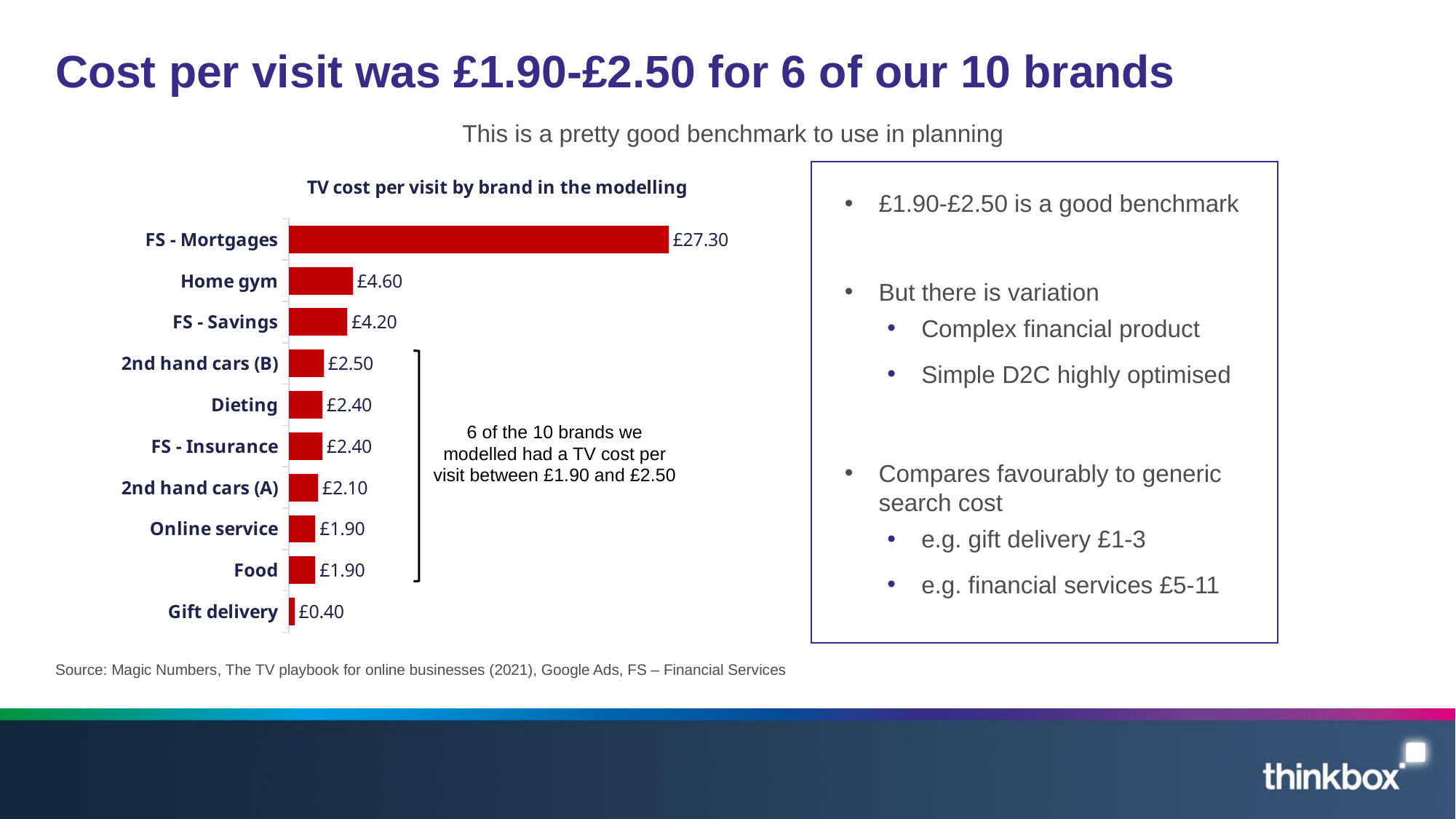
What is the TV cost per visit for 2nd hand cars (A)? £2.10 What is the title of the chart? TV cost per visit by brand in the modelling What is the difference in TV cost per visit between FS - Mortgages and Gift delivery? £26.90 Which has a higher TV cost per visit, 2nd hand cars (B) or Online service? 2nd hand cars (B) What is the TV cost per visit for Home gym? £4.60 How many brands are shown in the chart? 10 What is the difference in TV cost per visit between Home gym and FS - Savings? £0.40 What is the TV cost per visit for Gift delivery? £0.40 What is the TV cost per visit for FS - Mortgages? £27.30 Which brand has the highest TV cost per visit? FS - Mortgages What type of chart is used to show TV cost per visit by brand? Bar chart Which brand has the lowest TV cost per visit? Gift delivery